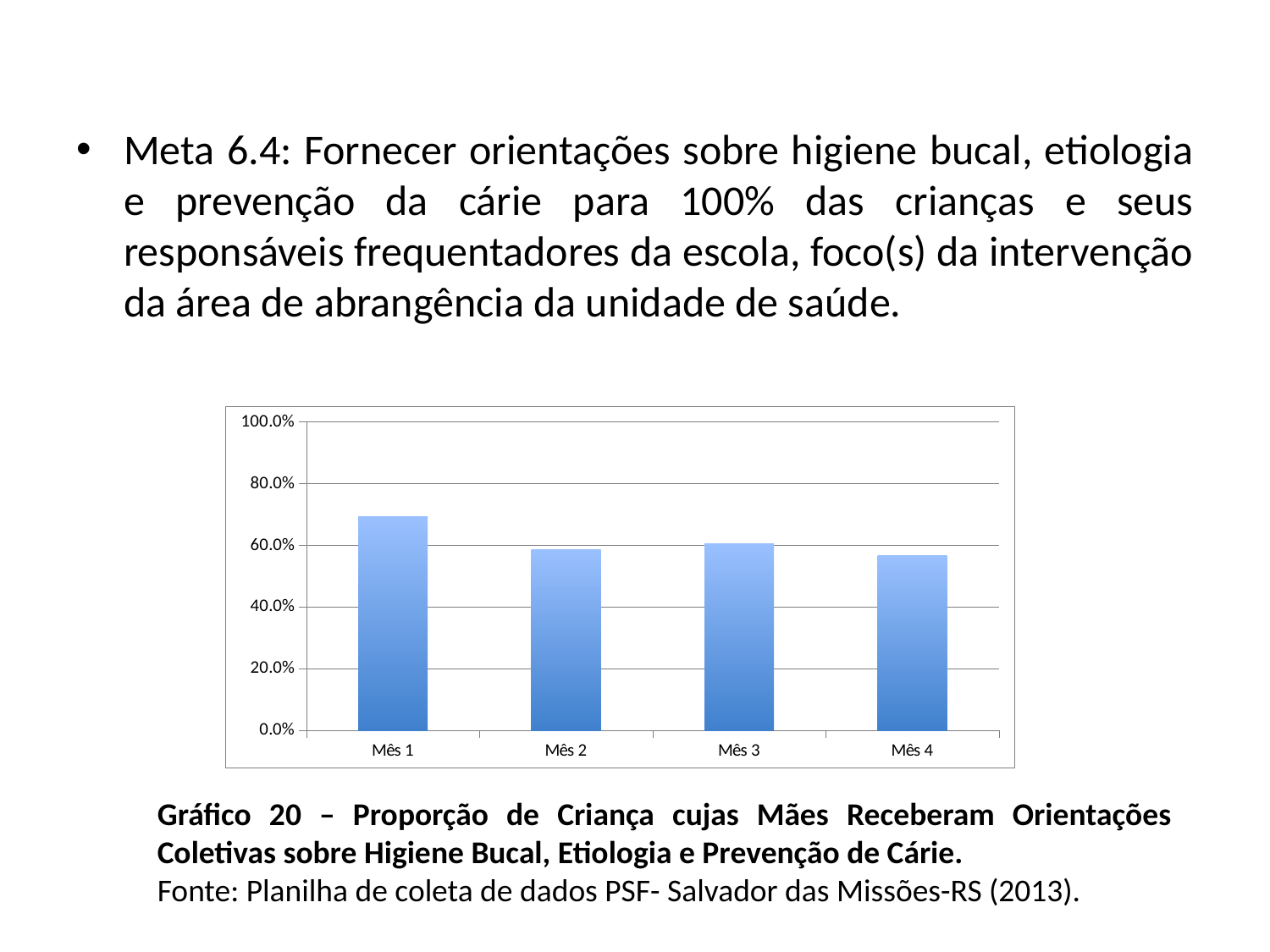
Which month has the highest value on the chart? Mês 1 What kind of chart is shown on the slide? bar chart How many categories (months) are plotted on the chart? 4 What is the number of the graph given in the caption below the chart? Gráfico 20 Is the value for Mês 2 greater or less than 40.0%? greater Is the value for Mês 1 greater or less than 60.0%? greater Which is larger, the value for Mês 3 or the value for Mês 4? Mês 3 Which is larger, the value for Mês 1 or the value for Mês 2? Mês 1 What is the highest value shown on the vertical axis of the chart? 100.0% Is the value for Mês 4 greater or less than 60.0%? less Is the value for Mês 4 higher or lower than the value for Mês 1? lower